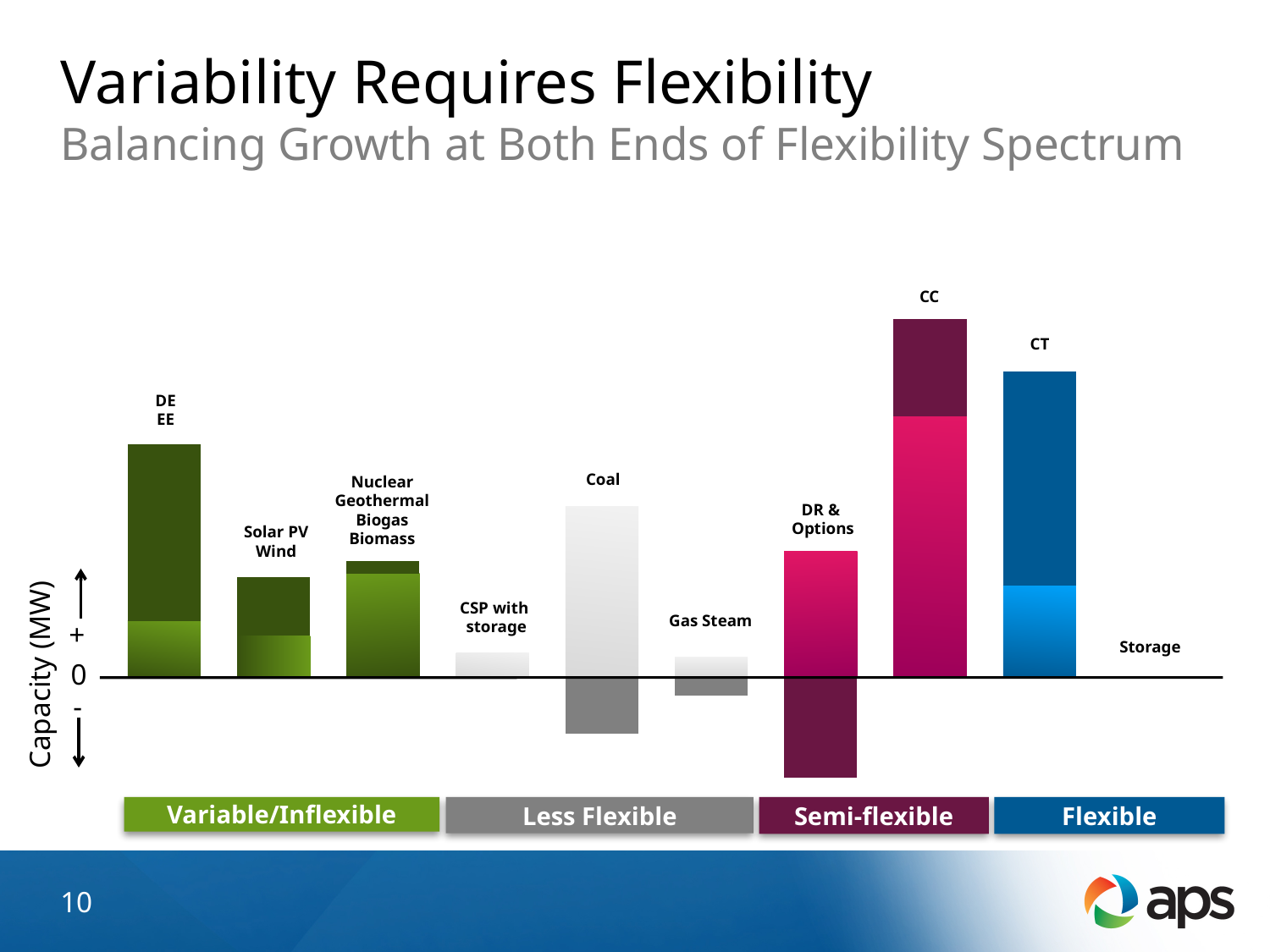
Which categories have bars that extend below zero? Coal, Gas Steam, DR & Options What kind of chart is shown on the slide? bar chart Which bar is taller above zero, Coal or Gas Steam? Coal Which flexibility group do the CC and CT bars belong to? CC belongs to Semi-flexible; CT belongs to Flexible What is the label on the vertical axis? Capacity (MW) Which bar is taller above zero, CC or CT? CC Which bar is taller above zero, Nuclear/Geothermal/Biogas/Biomass or CSP with storage? Nuclear/Geothermal/Biogas/Biomass How many flexibility groups are labelled along the bottom of the chart? 4 Which flexibility group does the Coal bar belong to? Less Flexible Which category has the tallest bar above zero? CC